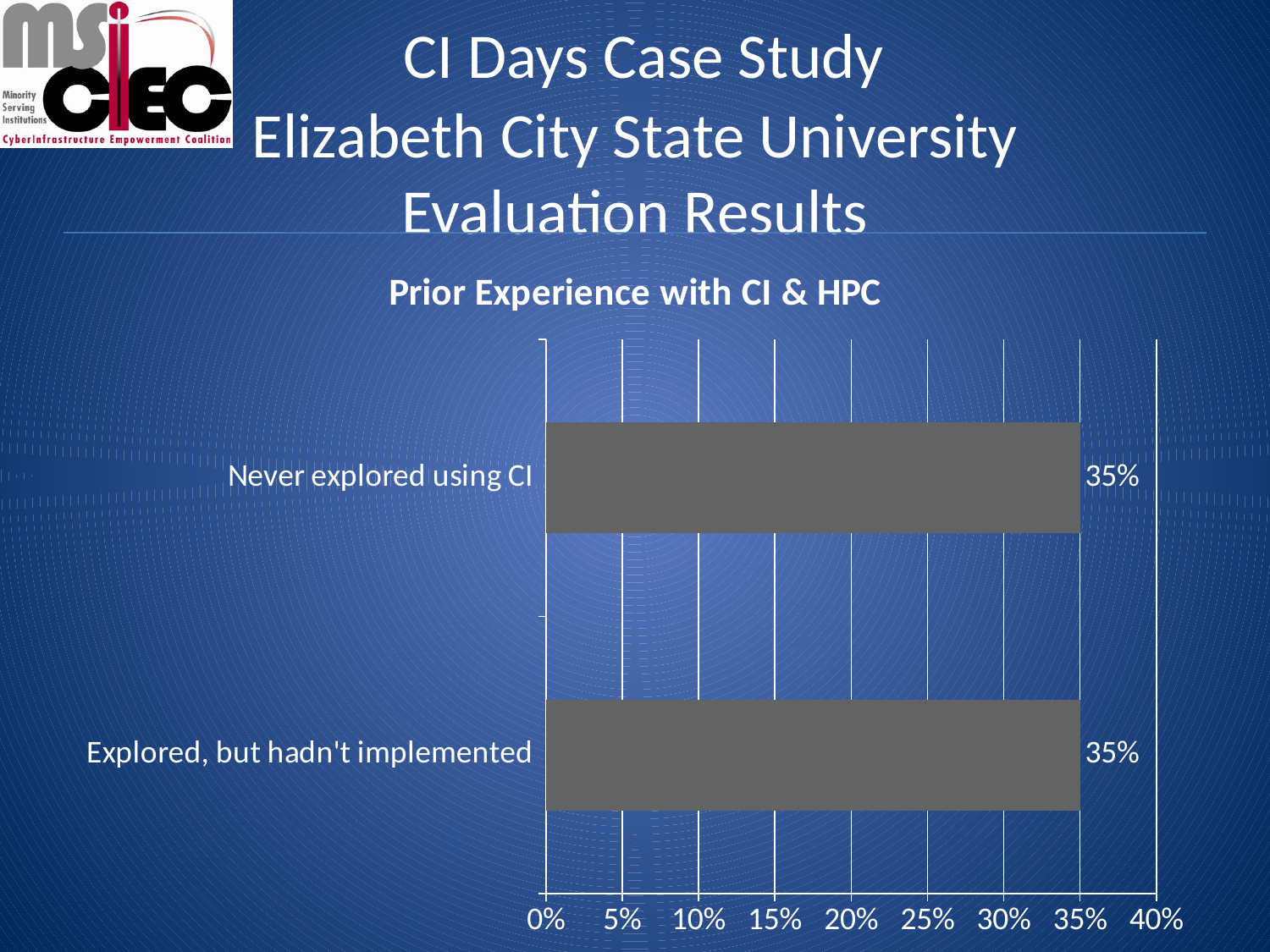
What is the difference between the values for "Never explored using CI" and "Explored, but hadn't implemented"? 0% What kind of chart is shown on the slide? Bar chart Is the value for "Never explored using CI" greater or less than 30%? greater How many categories are shown in the chart? 2 What is the maximum value shown on the x axis of the chart? 40% What is the title of the chart? Prior Experience with CI & HPC What is the value for "Never explored using CI"? 35% Is the value for "Explored, but hadn't implemented" greater or less than 40%? less What is the value for "Explored, but hadn't implemented"? 35%